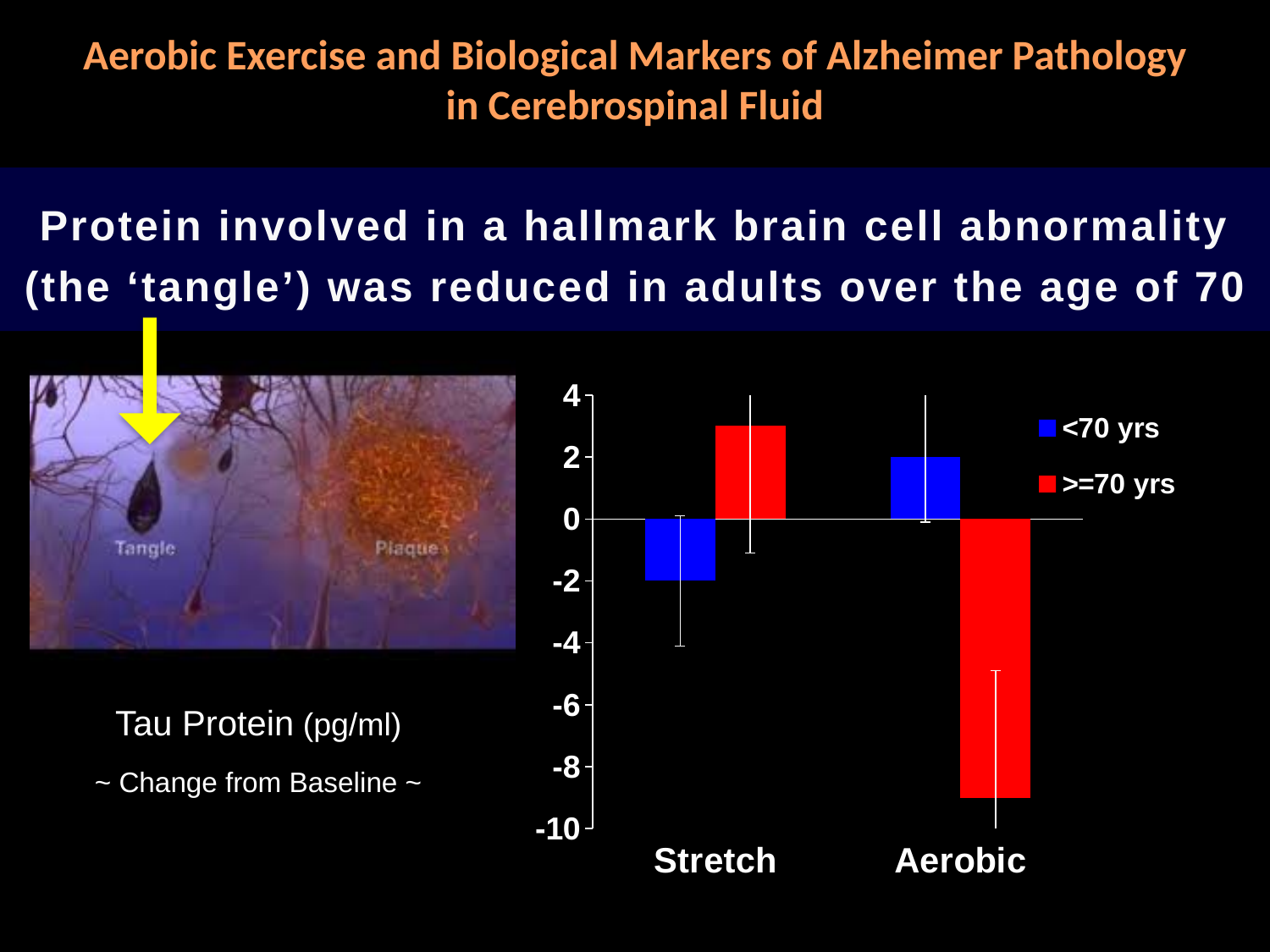
What is the value for the <70 yrs series in the Stretch category? -2 What is the difference between the <70 yrs values for Aerobic and Stretch? 4 Which colour represents the >=70 yrs series? red Is the value for the >=70 yrs series in the Stretch category greater or less than 2? greater Which bar has the lowest value on the chart? >=70 yrs, Aerobic Which bar has the highest value on the chart? >=70 yrs, Stretch What kind of chart is shown on the slide? bar chart How many series does the legend list? 2 Is the value for the >=70 yrs series in the Aerobic category greater or less than -8? less Which is larger: the >=70 yrs value for Stretch or the <70 yrs value for Aerobic? >=70 yrs value for Stretch How many categories are shown on the x axis? 2 What is the value for the <70 yrs series in the Aerobic category? 2